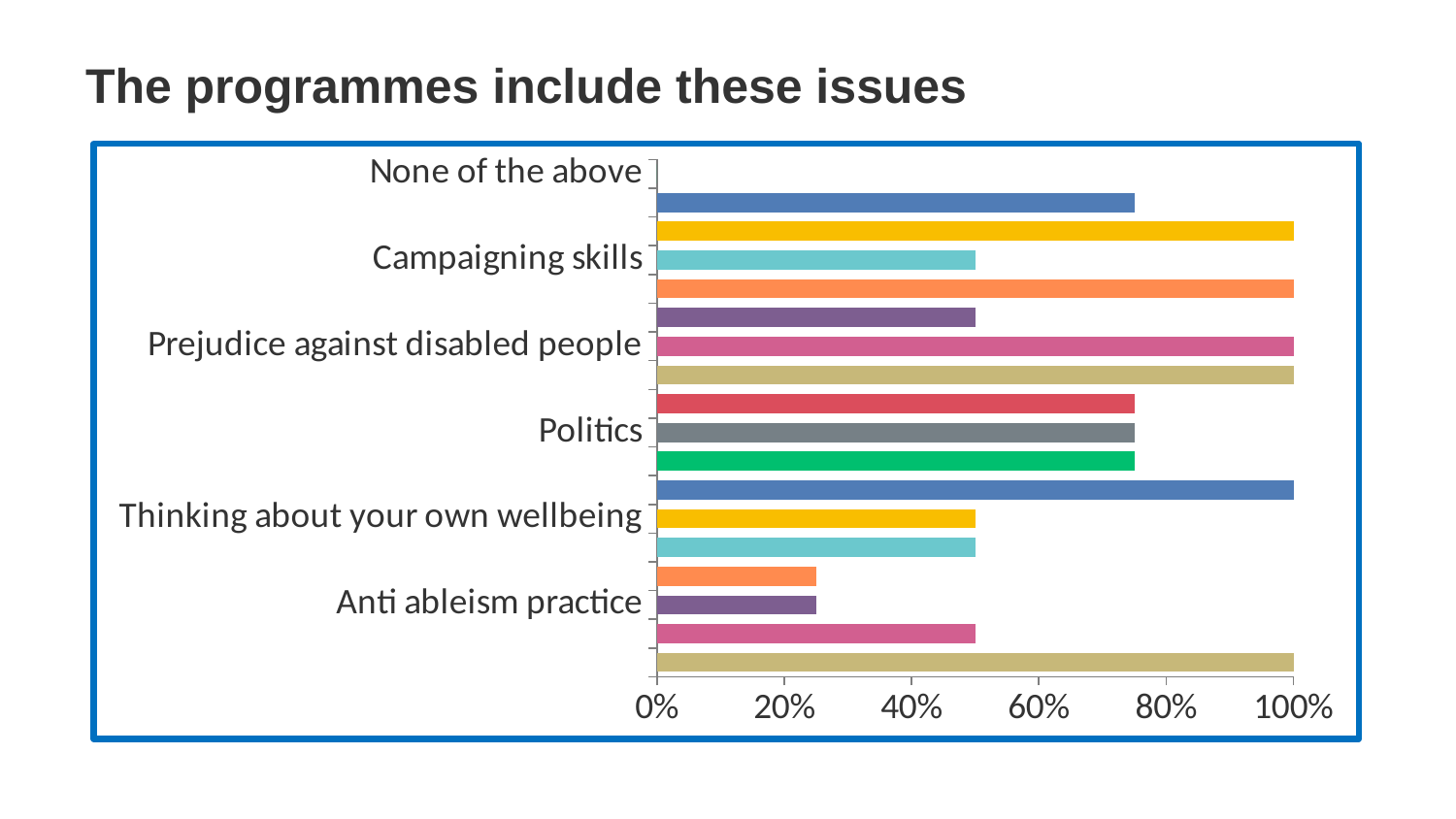
What is the value of the bar aligned with the 'Prejudice against disabled people' label? 100% What is the title of the slide containing the chart? The programmes include these issues How many category labels are readable on the vertical axis of the chart? 6 What is the highest value reached by any bar in the chart? 100% Which is larger: the bar for 'Politics' or the bar for 'Anti ableism practice'? Politics What is the maximum value shown on the horizontal axis? 100% What kind of chart is shown on the slide? bar chart